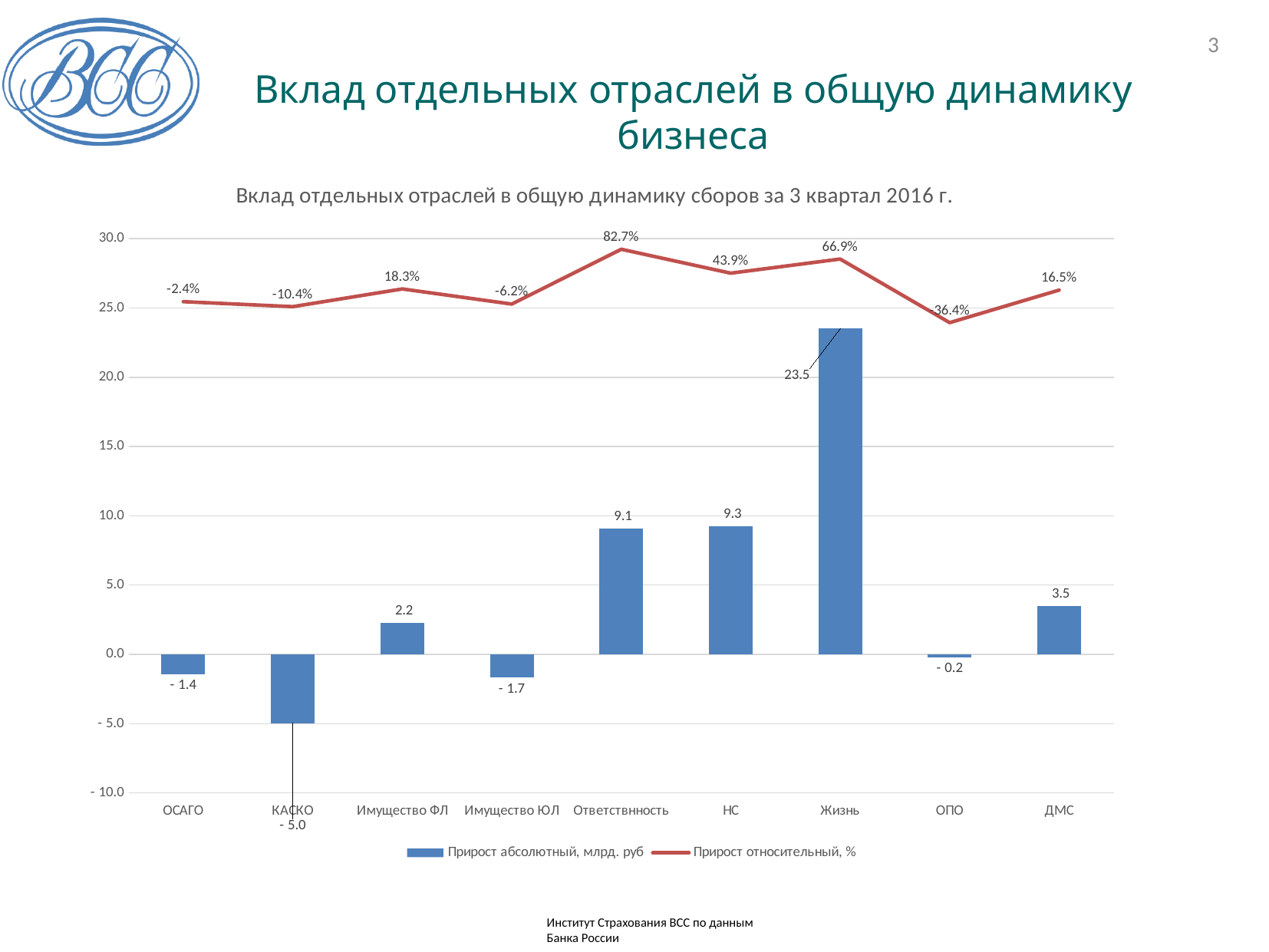
How many categories are shown on the x axis of the chart? 9 Which category has the lowest relative growth percentage? ОПО What is the title of the chart? Вклад отдельных отраслей в общую динамику сборов за 3 квартал 2016 г. What is the absolute growth (Прирост абсолютный, млрд. руб) for Жизнь? 23.5 What is the relative growth percentage shown for ОПО? -36.4% How many series does the legend list? 2 Which category has the highest absolute growth in billion rubles? Жизнь What is the absolute growth value shown for КАСКО? - 5.0 What is the difference in absolute growth between Жизнь and НС? 14.2 What is the relative growth (Прирост относительный, %) for Ответствнность? 82.7% Which has a larger absolute growth: Имущество ФЛ or ДМС? ДМС Which category has the lowest absolute growth in billion rubles? КАСКО